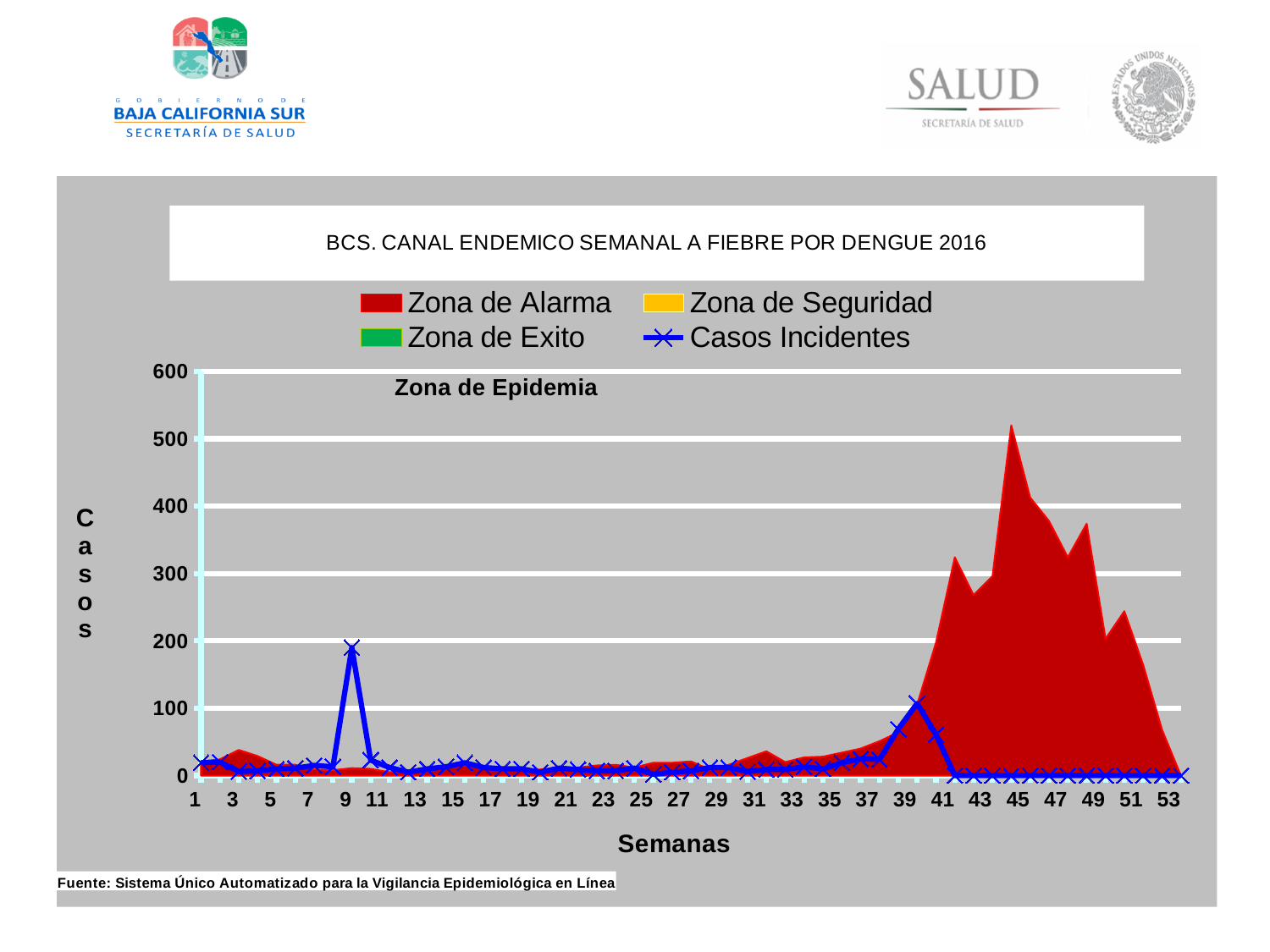
Around which week does the Zona de Alarma area reach its highest point? Week 44 What is the highest value shown on the y axis? 600 What is the title of the chart? BCS. CANAL ENDEMICO SEMANAL A FIEBRE POR DENGUE 2016 In which week does the Casos Incidentes line reach its highest value? Week 9 What kind of chart is shown on the slide? Area chart with a line series Is the value of Casos Incidentes in week 53 greater or less than 100? less Which series is drawn as a blue line with x markers? Casos Incidentes Which is larger: Casos Incidentes in week 9 or in week 40? Week 9 How many series does the legend list? 4 Is the value of Casos Incidentes in week 9 greater or less than 100? greater Is the peak of the Zona de Alarma area around week 45 greater or less than 500? greater